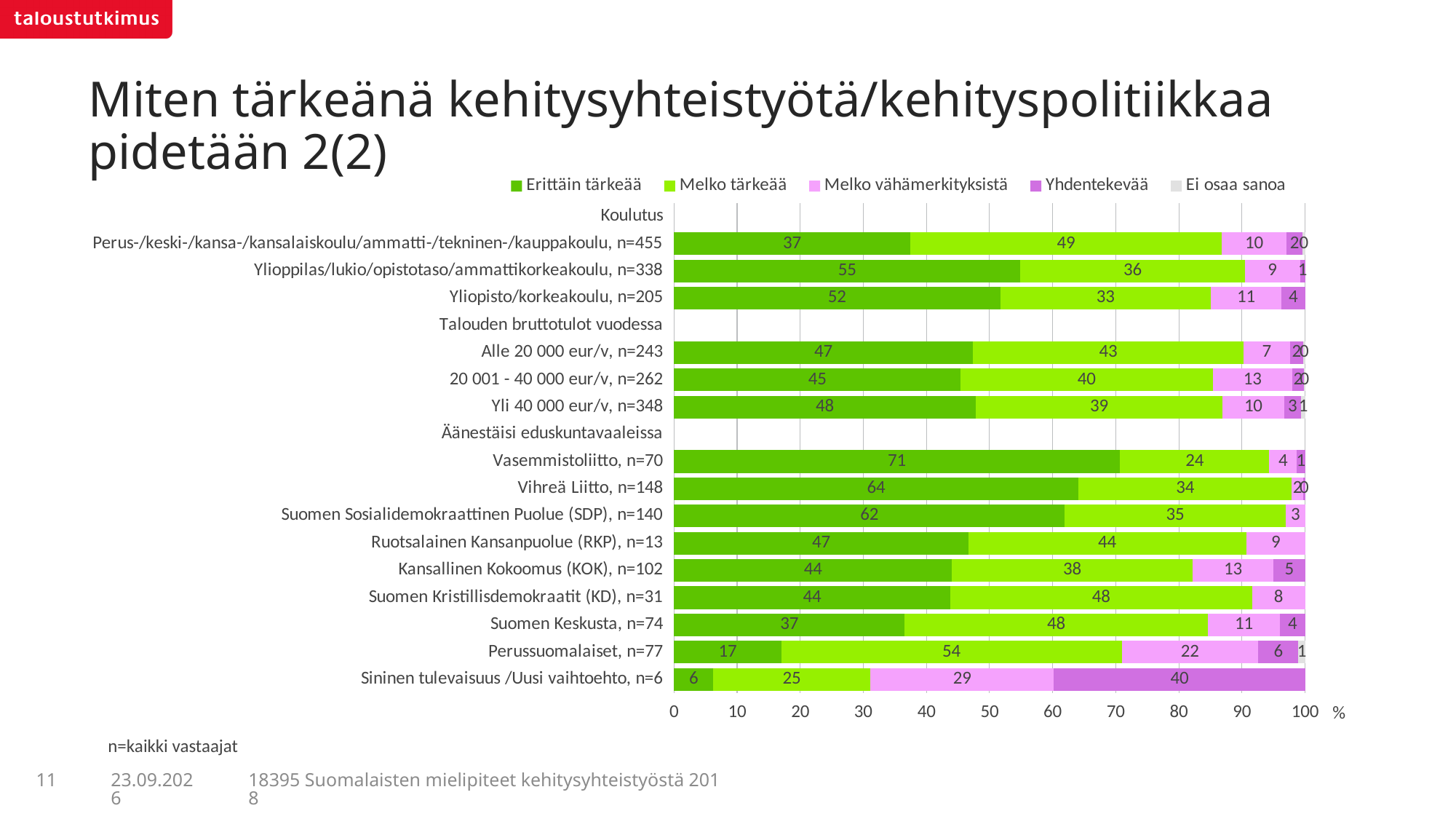
What is the 'Yhdentekevää' value for Sininen tulevaisuus /Uusi vaihtoehto, n=6? 40 How many series does the legend list? 5 Which category has the highest 'Erittäin tärkeää' value? Vasemmistoliitto, n=70 What is the 'Melko tärkeää' value for Perus-/keski-/kansa-/kansalaiskoulu/ammatti-/tekninen-/kauppakoulu, n=455? 49 Is the 'Erittäin tärkeää' value for Vihreä Liitto, n=148 greater or less than 60? greater What is the 'Erittäin tärkeää' value for Vasemmistoliitto, n=70? 71 Which category has the lowest 'Erittäin tärkeää' value? Sininen tulevaisuus /Uusi vaihtoehto, n=6 How many categories are listed under the group 'Äänestäisi eduskuntavaaleissa'? 9 What is the 'Melko tärkeää' value for Perussuomalaiset, n=77? 54 Which has a larger 'Melko vähämerkityksistä' value: Kansallinen Kokoomus (KOK), n=102 or Suomen Keskusta, n=74? Kansallinen Kokoomus (KOK), n=102 What is the difference between the 'Erittäin tärkeää' values for Vasemmistoliitto, n=70 and Perussuomalaiset, n=77? 54 What kind of chart is shown on the slide? Stacked bar chart